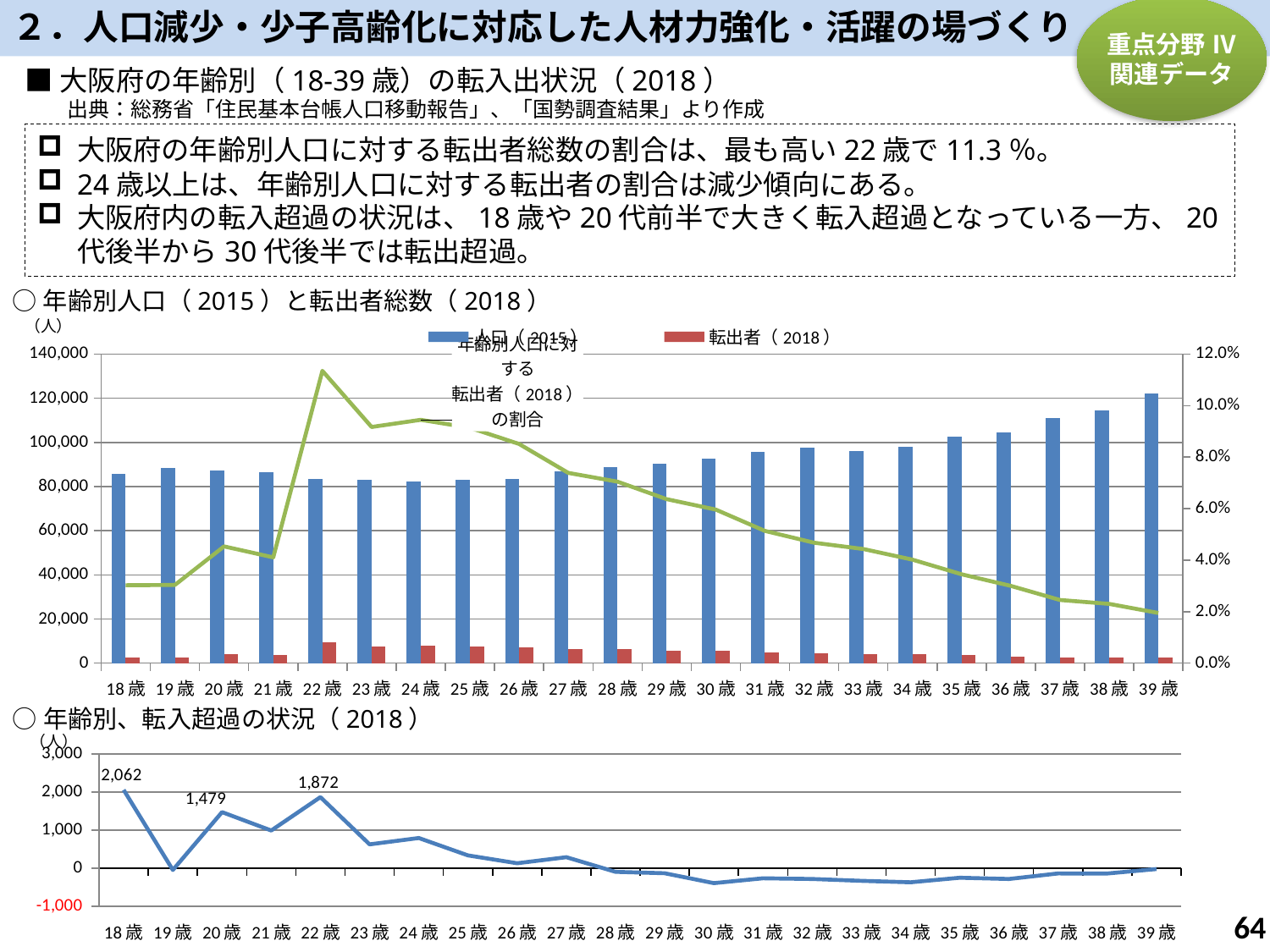
In the bottom chart (年齢別、転入超過の状況（2018）), what is the value for 18歳? 2,062 In the top chart (年齢別人口（2015）と転出者総数（2018）), at which age does the ratio line (年齢別人口に対する転出者（2018）の割合) reach its peak? 22歳 In the bottom chart (年齢別、転入超過の状況（2018）), what is the difference between the values for 18歳 and 22歳? 190 In the bottom chart (年齢別、転入超過の状況（2018）), which age has the highest value? 18歳 In the top chart (年齢別人口（2015）と転出者総数（2018）), does the ratio line (年齢別人口に対する転出者（2018）の割合) rise or fall from 24歳 to 39歳? fall In the bottom chart (年齢別、転入超過の状況（2018）), what is the value for 20歳? 1,479 In the top chart (年齢別人口（2015）と転出者総数（2018）), how many age categories are shown on the x axis? 22 In the top chart (年齢別人口（2015）と転出者総数（2018）), is the 人口（2015） value for 18歳 greater or less than 100,000? less In the top chart (年齢別人口（2015）と転出者総数（2018）), which age has the highest 人口（2015） bar? 39歳 In the bottom chart (年齢別、転入超過の状況（2018）), what is the value for 22歳? 1,872 In the bottom chart (年齢別、転入超過の状況（2018）), is the value for 30歳 greater or less than 0? less In the bottom chart (年齢別、転入超過の状況（2018）), what kind of chart is it? line chart